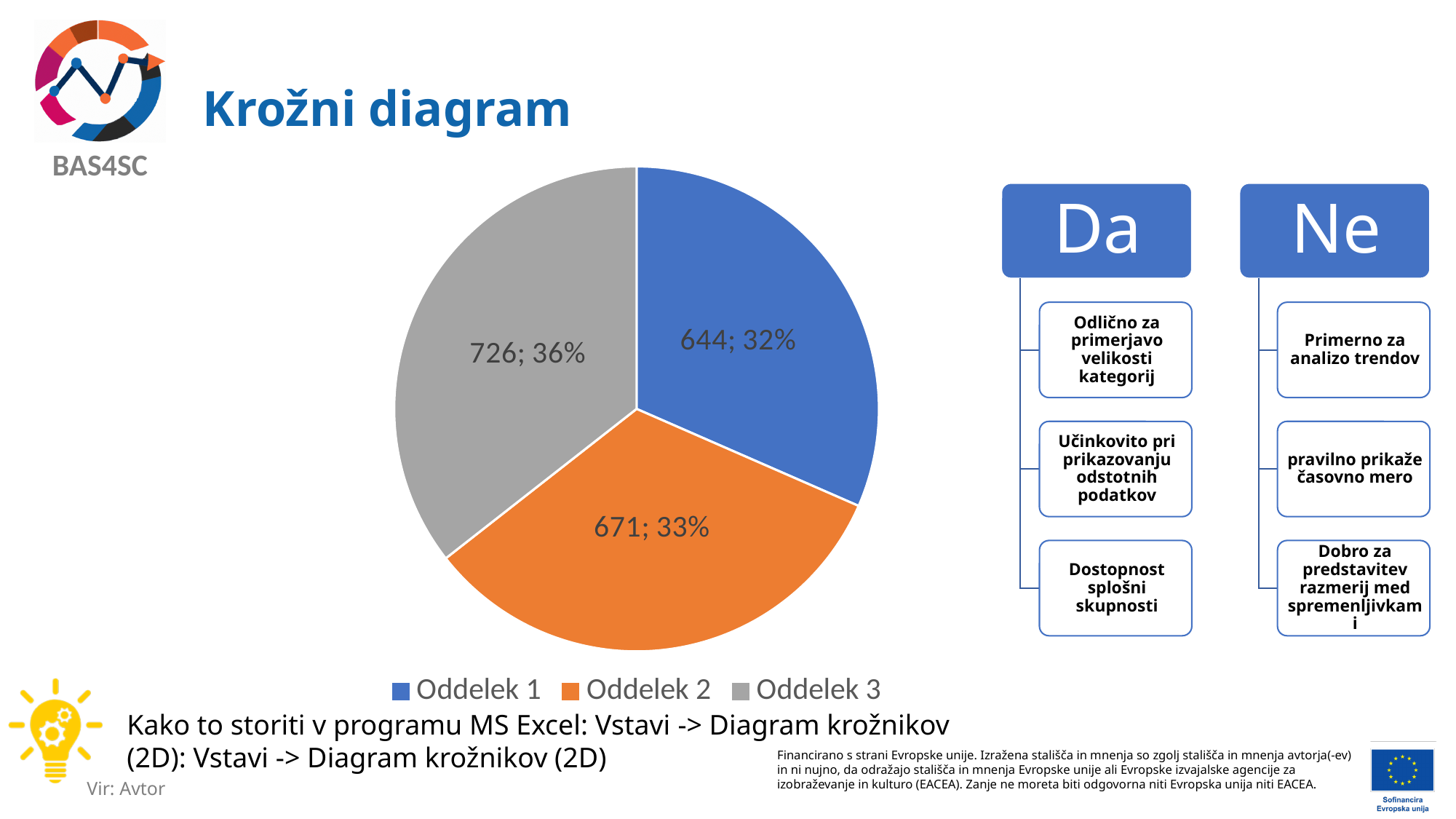
Which colour represents Oddelek 2 in the pie chart? orange What is the value for Oddelek 1? 644 What share of the pie does Oddelek 1 represent? 32% Which category has the largest slice? Oddelek 3 What is the value for Oddelek 3? 726 What kind of chart is shown on the slide? pie chart How many slices does the pie chart have? 3 What share of the pie does Oddelek 3 represent? 36% What is the difference between the values for Oddelek 3 and Oddelek 1? 82 What is the value for Oddelek 2? 671 Which category has the smallest slice? Oddelek 1 How many entries does the legend list? 3